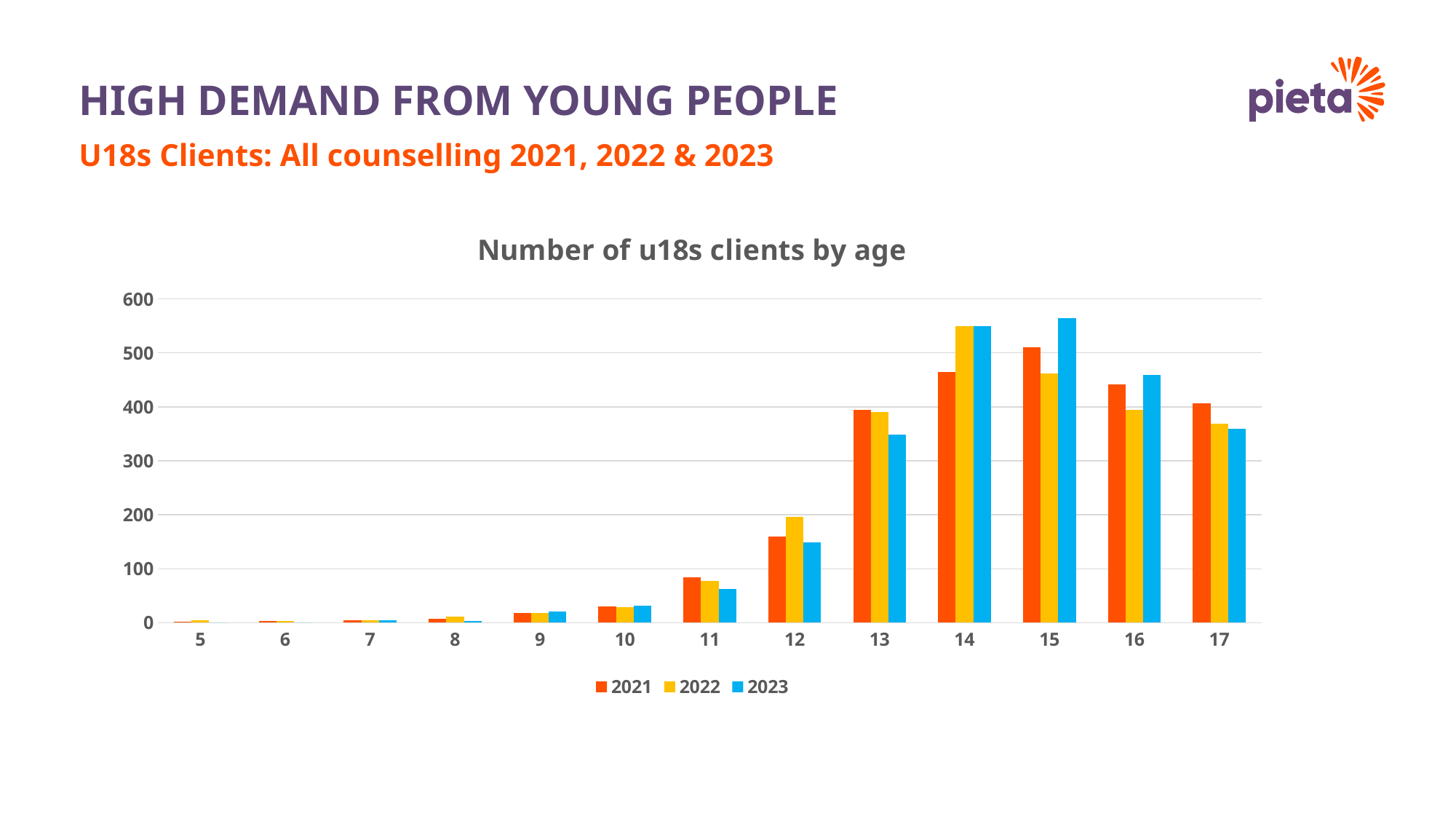
At age 14, which series has the larger value, 2021 or 2022? 2022 Is the value for 2023 at age 13 greater or less than 400? less At age 13, which series has the larger value, 2021 or 2023? 2021 Is the value for 2022 at age 12 greater or less than 150? greater What kind of chart is shown on the slide? Bar chart Is the value for 2023 at age 15 greater or less than 500? greater Which age has the highest value for the 2021 series? 15 How many age categories are shown on the x axis? 13 Do the values for the 2022 series rise or fall from age 5 to age 14? Rise What is the title of the chart? Number of u18s clients by age Which age has the highest value for the 2022 series? 14 How many series does the legend list? 3